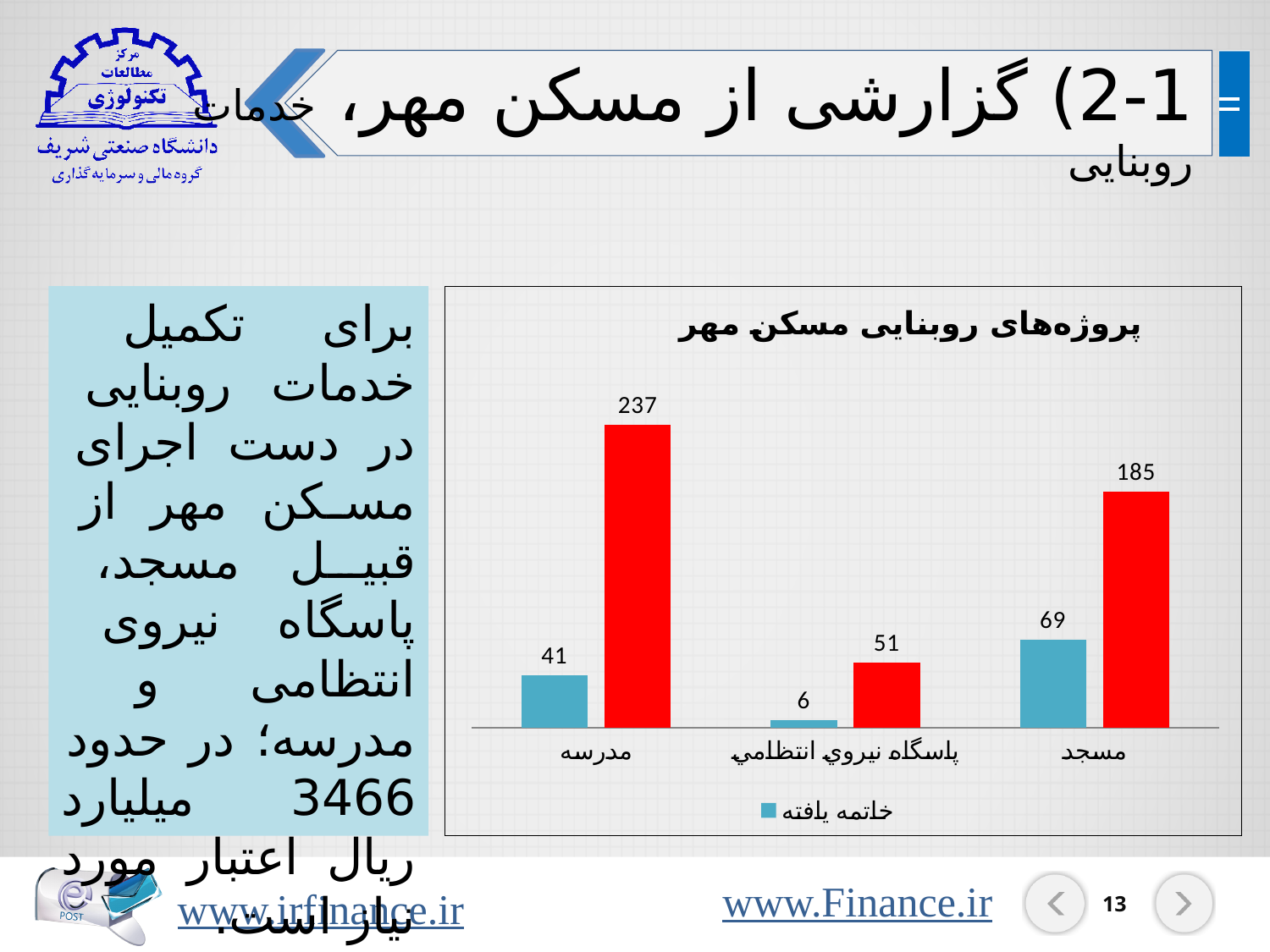
What is the difference between the red bars for مدرسه and مسجد? 52 How many entries does the chart's legend list? 1 How many categories are shown on the x axis of the chart? 3 Which category has the highest red bar? مدرسه What is the difference between the red bar and the blue bar for مدرسه? 196 Which category has the lowest خاتمه یافته (blue) bar? پاسگاه نیروی انتظامی What is the value of the red bar for مسجد? 185 What is the title of the chart? پروژه‌های روبنایی مسکن مهر What is the value of the خاتمه یافته (blue) bar for پاسگاه نیروی انتظامی? 6 What is the value of the خاتمه یافته (blue) bar for مدرسه? 41 Which is larger: the خاتمه یافته value for مسجد or for مدرسه? مسجد What type of chart is shown on the slide? bar chart